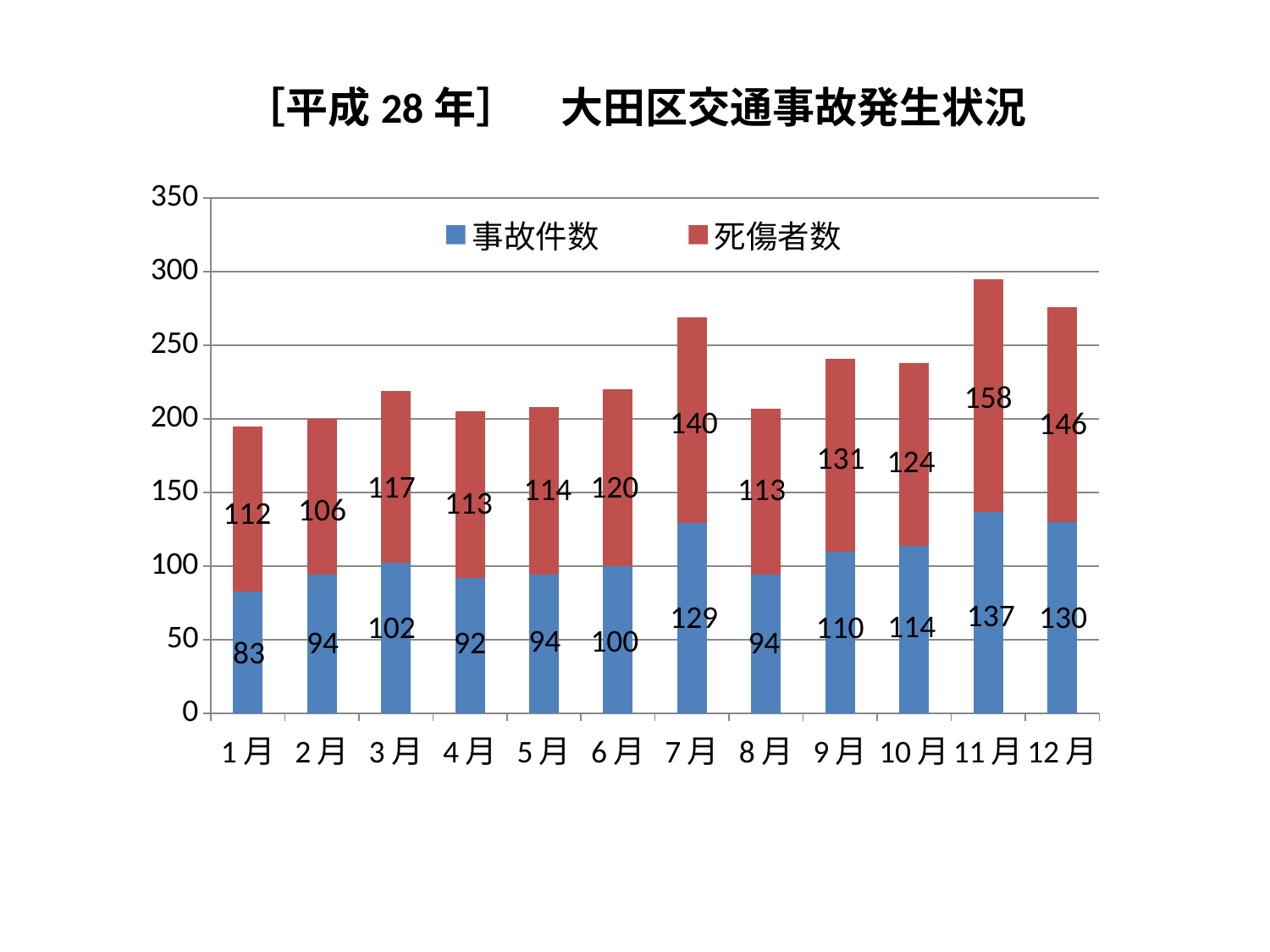
Which month has the highest 事故件数? 11月 Which month has the lowest 事故件数? 1月 How many series does the legend list? 2 How many months are shown on the x axis? 12 What kind of chart is shown on the slide? Stacked bar chart What is the 死傷者数 value for 11月? 158 Which month has the lowest 死傷者数? 2月 Which is larger, the 事故件数 for 9月 or for 10月? 10月 What is the 死傷者数 value for 1月? 112 What is the 事故件数 value for 7月? 129 What is the difference between the 死傷者数 for 11月 and 12月? 12 What is the total of the stacked bar for 7月? 269